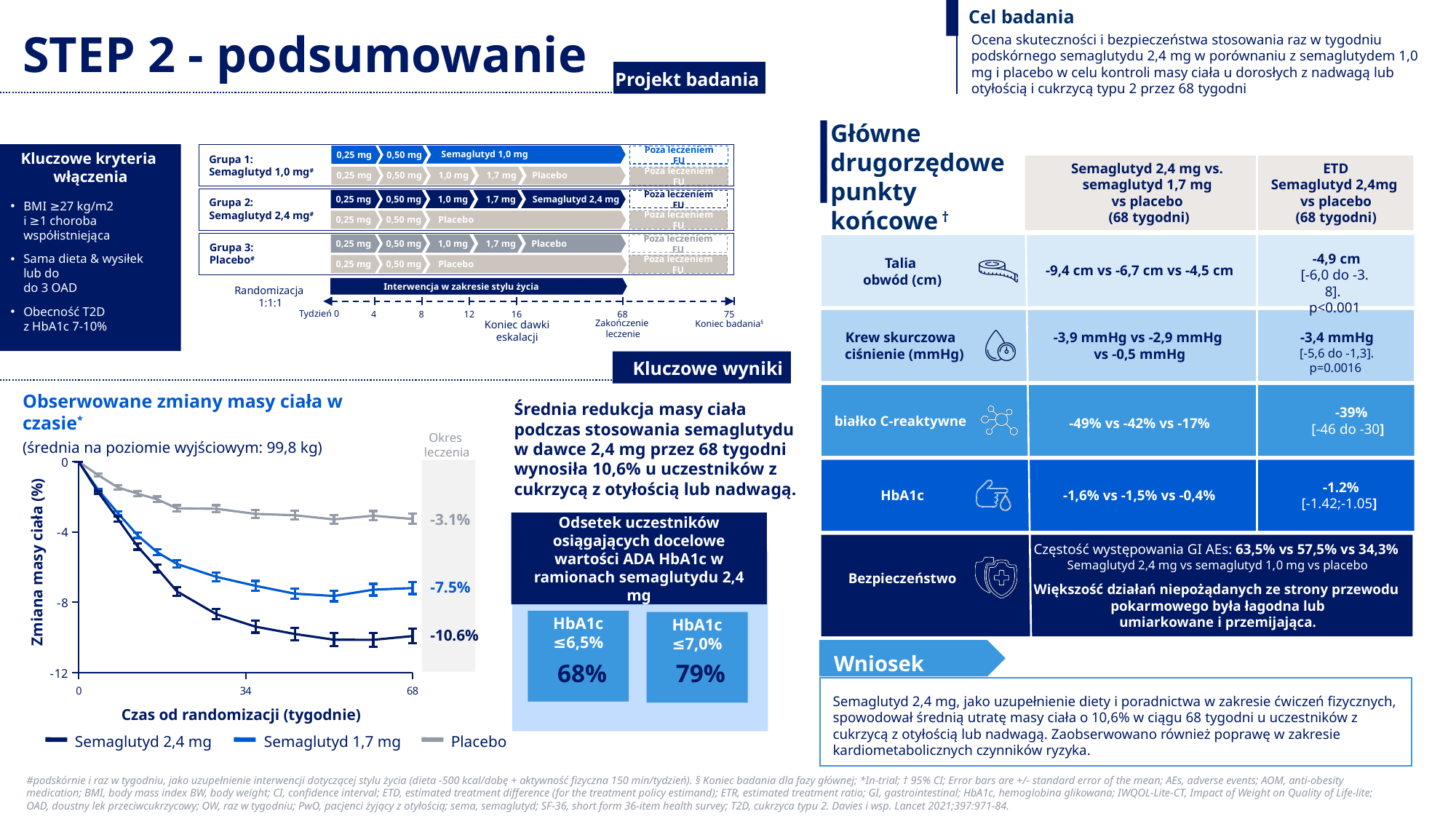
What is the x-axis label of the 'Obserwowane zmiany masy ciała w czasie' chart? Czas od randomizacji (tygodnie) In the 'Obserwowane zmiany masy ciała w czasie' chart, which series shows the smallest weight reduction at the end of the treatment period? Placebo In the 'Obserwowane zmiany masy ciała w czasie' chart, what is the final labelled value for Semaglutyd 2,4 mg? -10.6% What kind of chart is 'Obserwowane zmiany masy ciała w czasie'? line chart In the 'Obserwowane zmiany masy ciała w czasie' chart, what is the difference between the final values for Semaglutyd 2,4 mg and Placebo? 7.5 percentage points In the 'Obserwowane zmiany masy ciała w czasie' chart, what is the difference between the final values for Semaglutyd 2,4 mg and Semaglutyd 1,7 mg? 3.1 percentage points In the 'Obserwowane zmiany masy ciała w czasie' chart, do the values for Semaglutyd 2,4 mg rise or fall along the x axis? fall In the 'Obserwowane zmiany masy ciała w czasie' chart, what is the final labelled value for Placebo? -3.1% In the 'Obserwowane zmiany masy ciała w czasie' chart, is the final value for Semaglutyd 1,7 mg greater or less than -8? greater How many series does the legend of the 'Obserwowane zmiany masy ciała w czasie' chart list? 3 In the 'Obserwowane zmiany masy ciała w czasie' chart, what is the final labelled value for Semaglutyd 1,7 mg? -7.5% In the 'Obserwowane zmiany masy ciała w czasie' chart, which series shows the largest weight reduction at the end of the treatment period? Semaglutyd 2,4 mg